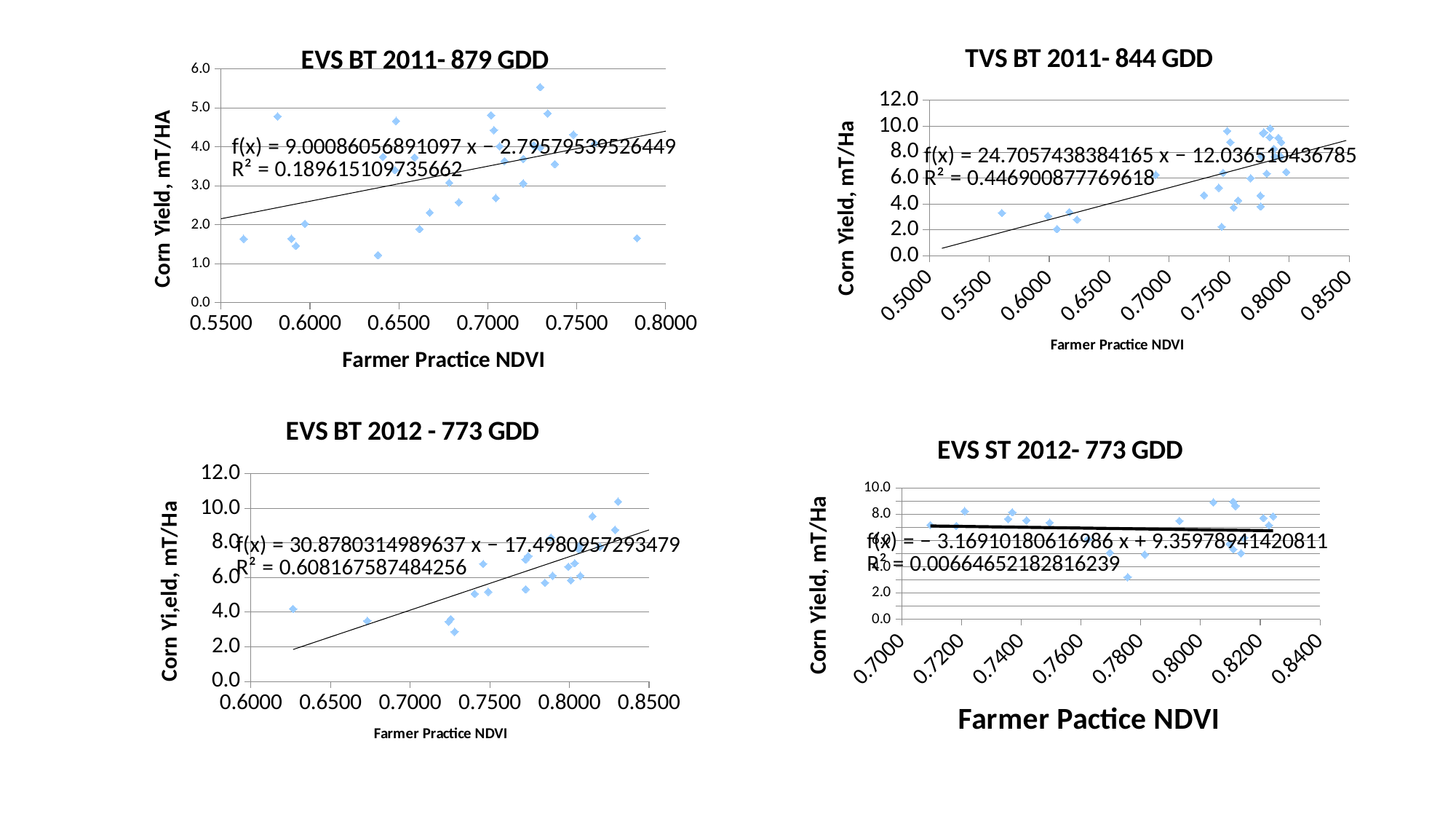
What is the R² value shown on the 'EVS BT 2011- 879 GDD' chart? 0.189615109735662 In the 'EVS BT 2011- 879 GDD' chart, is the highest plotted corn yield greater or less than 5.0? greater What is the R² value shown on the 'TVS BT 2011- 844 GDD' chart? 0.446900877769618 In the 'EVS BT 2012 - 773 GDD' chart, is the lowest plotted corn yield greater or less than 4.0? less What is the x-axis label of the 'EVS BT 2011- 879 GDD' chart? Farmer Practice NDVI What kind of chart is 'EVS BT 2011- 879 GDD'? Scatter chart What is the R² value shown on the 'EVS BT 2012 - 773 GDD' chart? 0.608167587484256 Which of the four charts shows the highest R² value? EVS BT 2012 - 773 GDD In the 'EVS BT 2011- 879 GDD' chart, does the fitted trendline rise or fall as Farmer Practice NDVI increases? Rises How many charts are shown on the slide? 4 In the 'EVS ST 2012- 773 GDD' chart, does the fitted trendline rise or fall as NDVI increases? Falls What is the R² value shown on the 'EVS ST 2012- 773 GDD' chart? 0.00664652182816239